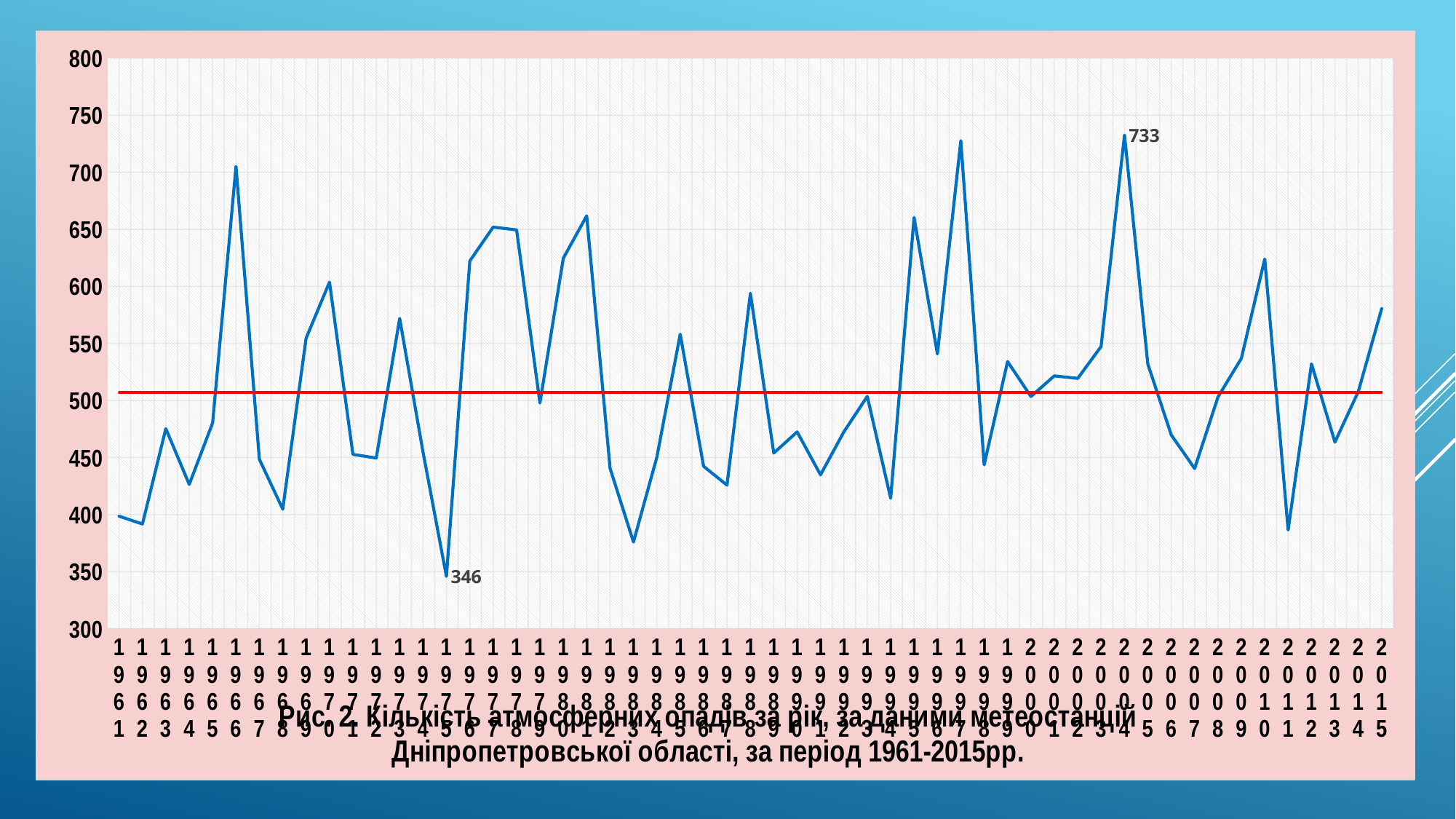
What kind of chart is shown on the slide? line chart Is the value for 1966 greater or less than 650? greater What is the precipitation value labelled for 1975? 346 Is the value for 1961 greater or less than 450? less Which year has the lowest annual precipitation value on the chart? 1975 What is the difference between the labelled maximum (2004) and the labelled minimum (1975)? 387 Which year has the larger value, 2004 or 1966? 2004 Is the value for 1983 greater or less than 400? less What is the precipitation value labelled for 2004? 733 How many years (data points) are plotted on the x axis? 55 What colour is the horizontal reference line drawn across the chart? red Which year has the highest annual precipitation value on the chart? 2004